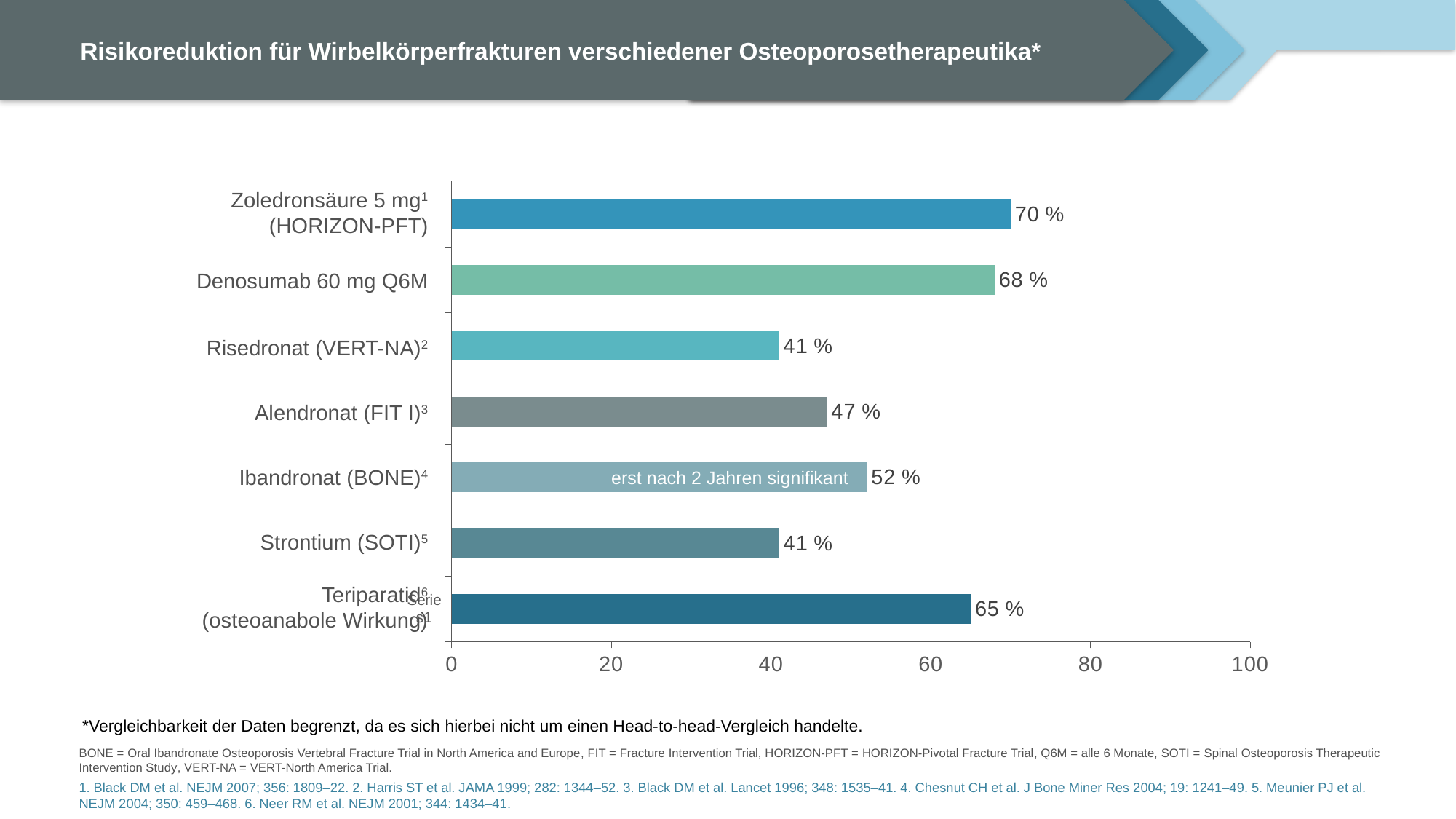
What value is shown for Teriparatid (osteoanabole Wirkung)? 65 % What is the difference between the values for Zoledronsäure 5 mg (HORIZON-PFT) and Denosumab 60 mg Q6M? 2 percentage points What is the lowest value shown in the chart? 41 % What is the risk reduction value shown for Zoledronsäure 5 mg (HORIZON-PFT)? 70 % How many therapies are shown in the chart? 7 What value is shown for Denosumab 60 mg Q6M? 68 % What text is written on the bar for Ibandronat (BONE)? erst nach 2 Jahren signifikant Which has a larger value, Denosumab 60 mg Q6M or Teriparatid (osteoanabole Wirkung)? Denosumab 60 mg Q6M Which therapy has the highest risk reduction value in the chart? Zoledronsäure 5 mg (HORIZON-PFT) What kind of chart is shown on the slide? bar chart Is the value for Alendronat (FIT I) greater or less than 40? greater What value is shown for Ibandronat (BONE)? 52 %